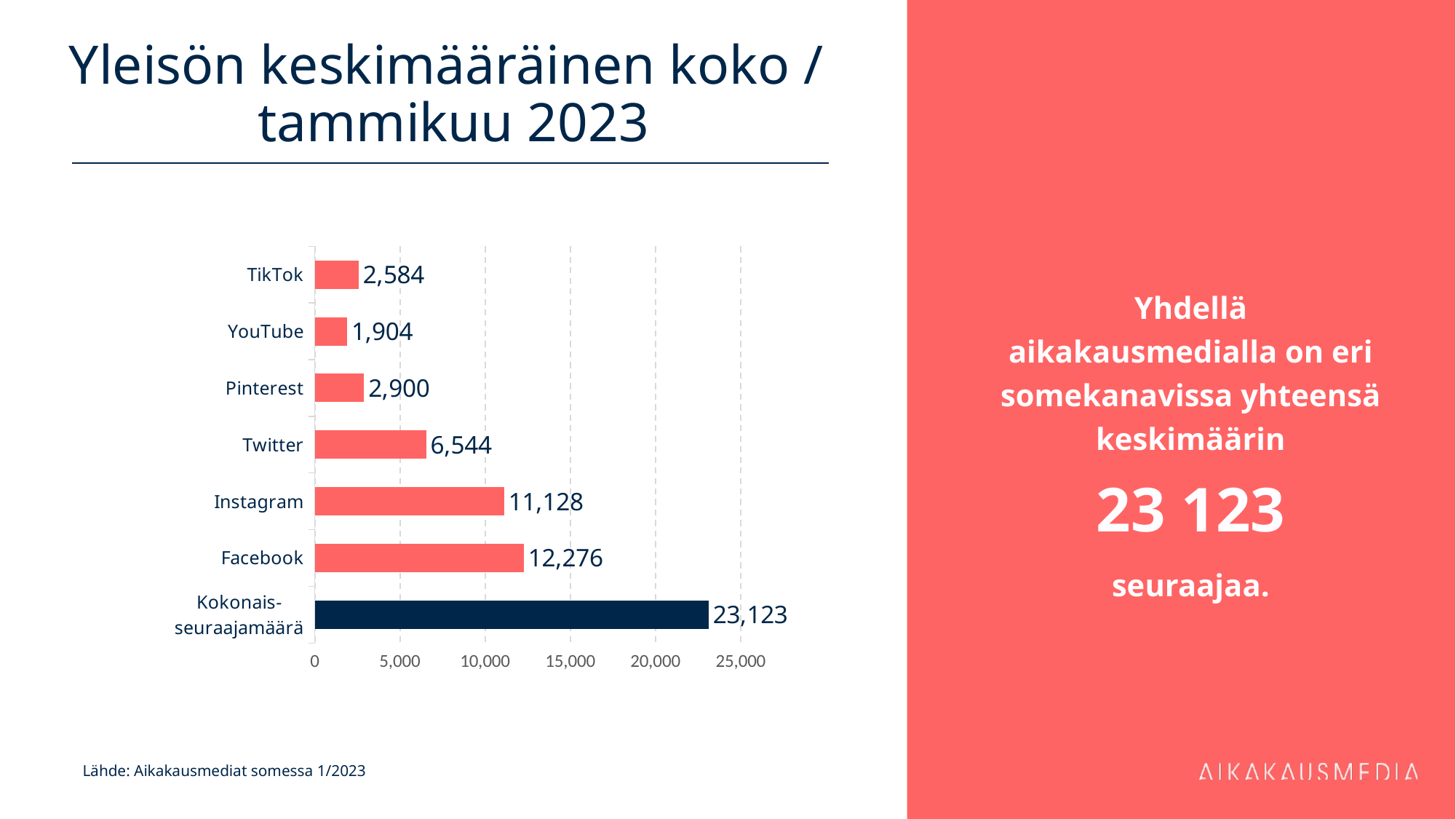
What is the value for TikTok? 2,584 Which individual social media channel (excluding the total bar) has the highest value? Facebook Which category has the lowest value? YouTube What kind of chart is shown on the slide? bar chart What is the value for Instagram? 11,128 What is the value for Facebook? 12,276 What is the difference between the values for Pinterest and YouTube? 996 Which is larger, the value for Twitter or the value for Pinterest? Twitter What is the difference between the values for Facebook and Instagram? 1,148 Is the value for Twitter greater or less than 5,000? greater What is the value for Kokonais-seuraajamäärä? 23,123 How many bars are shown in the chart? 7